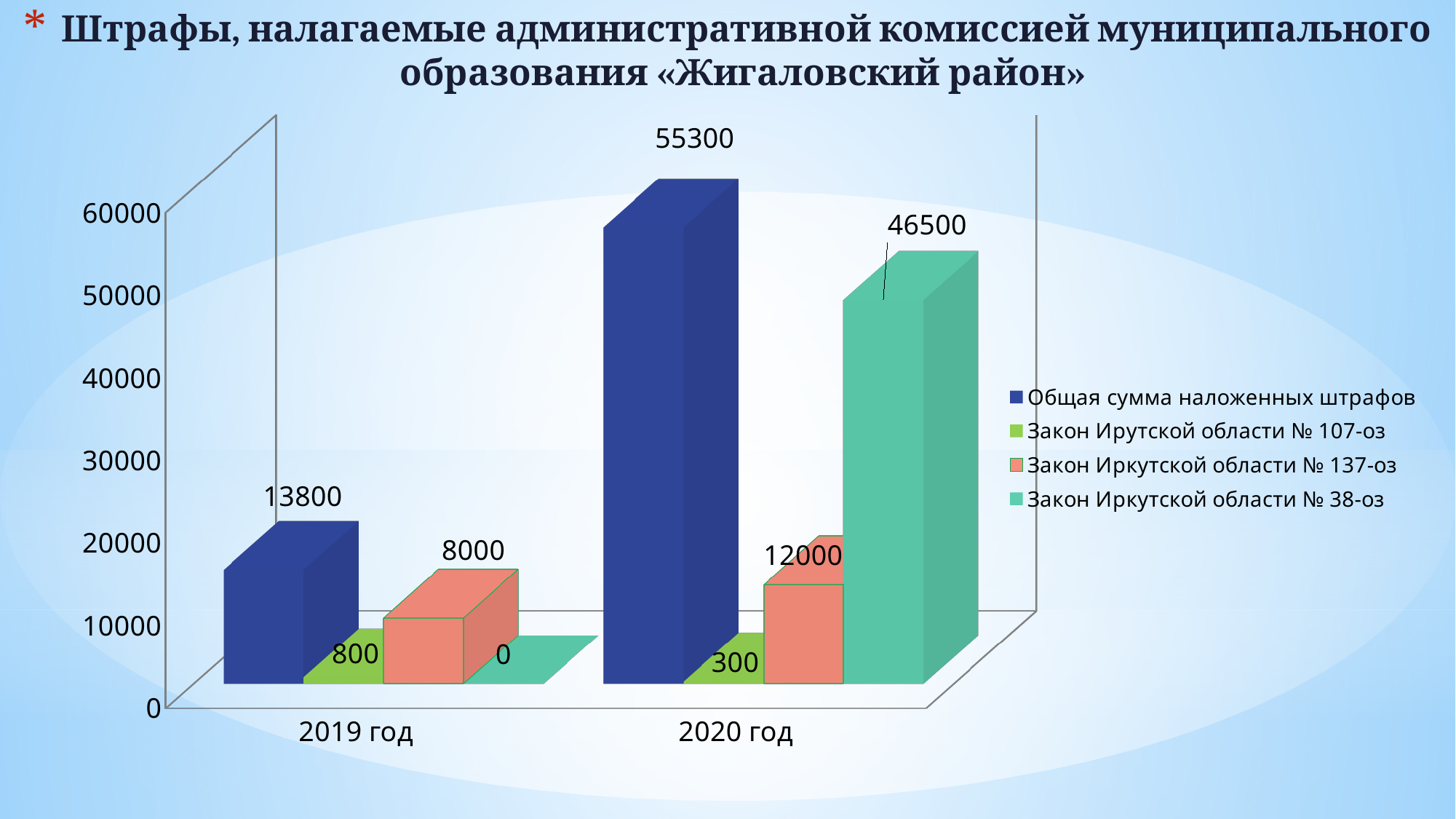
What is the value of «Закон Иркутской области № 137-оз» for 2019 год? 8000 What kind of chart is shown on the slide? Bar chart What is the value of «Общая сумма наложенных штрафов» for 2020 год? 55300 What is the value of «Закон Иркутской области № 38-оз» for 2020 год? 46500 How many series does the legend list? 4 What is the difference between «Общая сумма наложенных штрафов» in 2020 год and in 2019 год? 41500 Which year has the higher value for «Общая сумма наложенных штрафов»? 2020 год How many year categories are shown on the x axis? 2 What is the value of «Закон Иркутской области № 38-оз» for 2019 год? 0 Does the value of «Закон Ирутской области № 107-оз» rise or fall from 2019 год to 2020 год? Fall What is the difference between «Закон Иркутской области № 137-оз» in 2020 год and in 2019 год? 4000 What is the value of «Закон Ирутской области № 107-оз» for 2019 год? 800